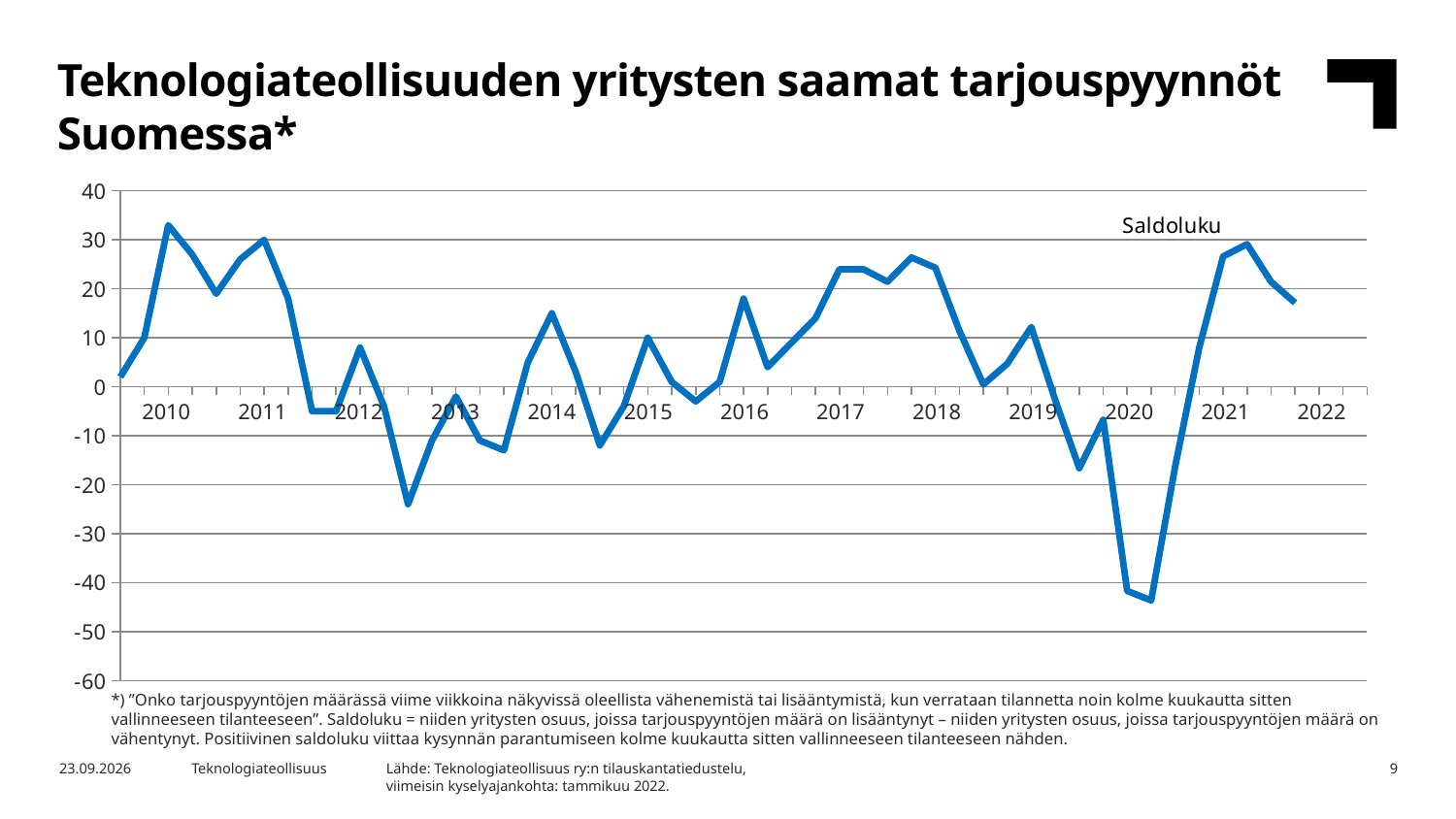
How many year labels are shown on the x axis? 13 Does the line rise or fall between its low point in 2020 and its peak in 2021? rises Is the lowest value of the line in 2020 greater or less than -40? less What is the name of the series shown in the chart? Saldoluku How many series does the chart plot? 1 In which year does the line reach its lowest value? 2020 Is the peak value of the line in 2010 greater or less than 30? greater What is the title of the chart on the slide? Teknologiateollisuuden yritysten saamat tarjouspyynnöt Suomessa* What kind of chart is shown on the slide? line chart Is the last plotted value of the line (in 2022) greater or less than 10? greater Does the line rise or fall from its 2021 peak to the last point in 2022? falls